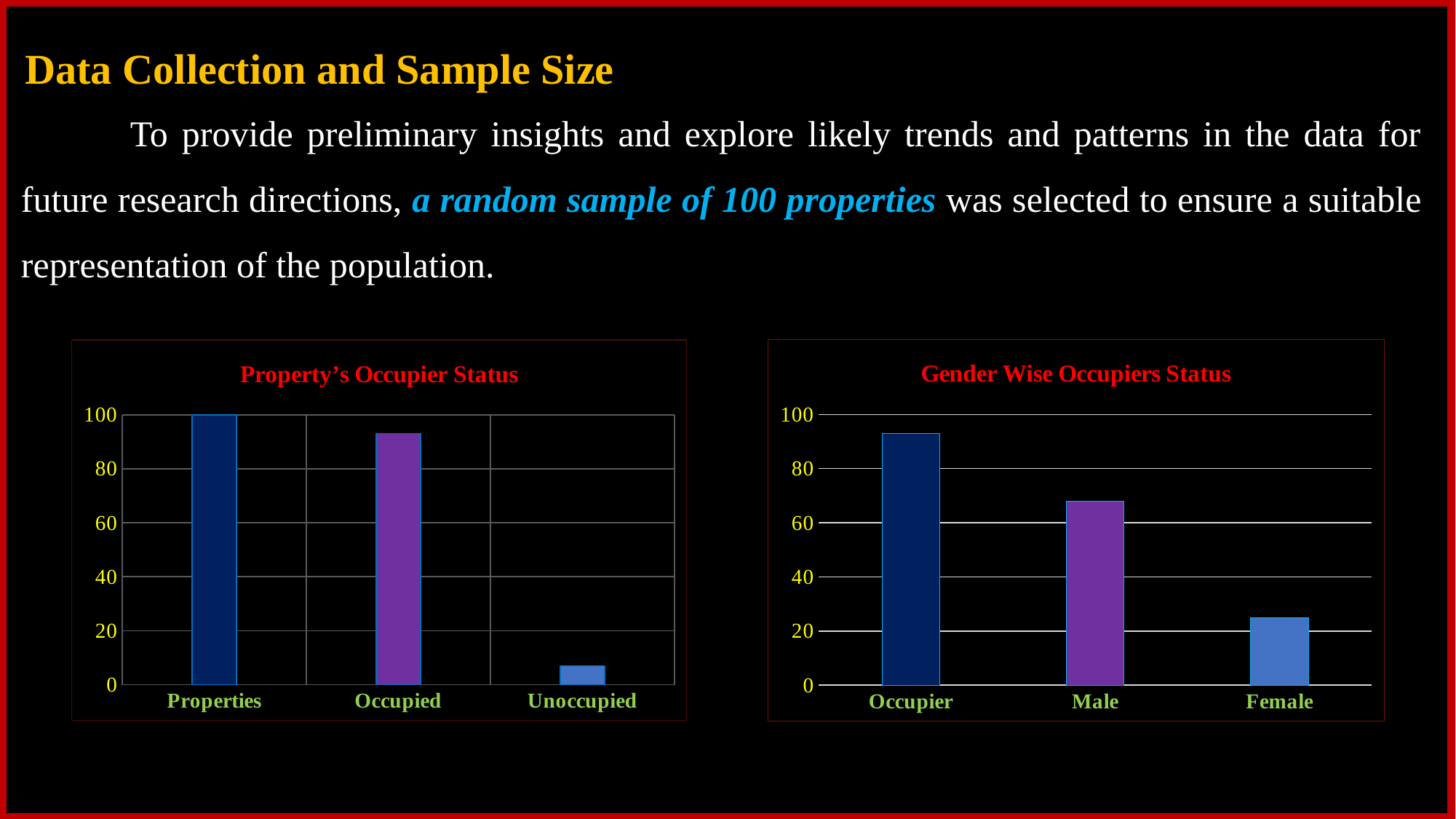
In the 'Property's Occupier Status' chart, which category has the highest value? Properties What kind of chart is 'Gender Wise Occupiers Status'? bar chart In the 'Gender Wise Occupiers Status' chart, which is larger, the value for Male or the value for Female? Male In the 'Property's Occupier Status' chart, is the value for Occupied greater or less than 80? greater In the 'Gender Wise Occupiers Status' chart, is the value for Male greater or less than 60? greater In the 'Gender Wise Occupiers Status' chart, which category has the highest value? Occupier In the 'Property's Occupier Status' chart, is the value for Unoccupied greater or less than 20? less In the 'Property's Occupier Status' chart, what is the value for Properties? 100 In the 'Gender Wise Occupiers Status' chart, which category has the lowest value? Female How many categories are shown in the 'Property's Occupier Status' chart? 3 In the 'Property's Occupier Status' chart, which category has the lowest value? Unoccupied